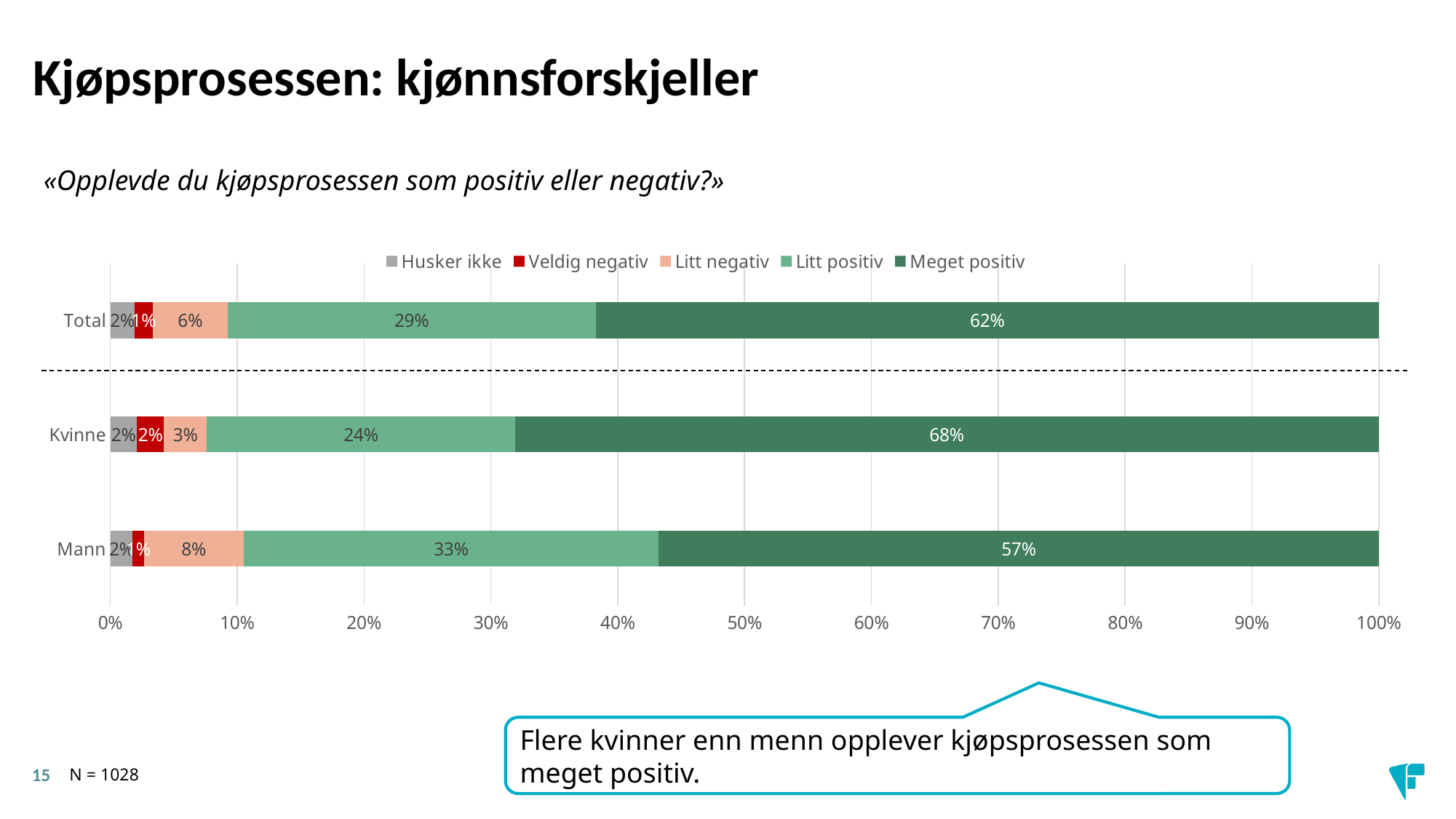
How many categories are shown on the y axis? 3 How many series does the legend list? 5 Which is larger, the Litt negativ value for Mann or for Kvinne? Mann What kind of chart is shown on the slide? Stacked bar chart What is the value of Litt negativ for Total? 6% What is the value of Veldig negativ for Kvinne? 2% Which category has the highest value for Meget positiv? Kvinne What is the value of Meget positiv for Kvinne? 68% Which category has the lowest value for Litt positiv? Kvinne What is the value of Litt positiv for Mann? 33% What is the difference between the Meget positiv values for Kvinne and Mann? 11% What is the question quoted above the chart? «Opplevde du kjøpsprosessen som positiv eller negativ?»